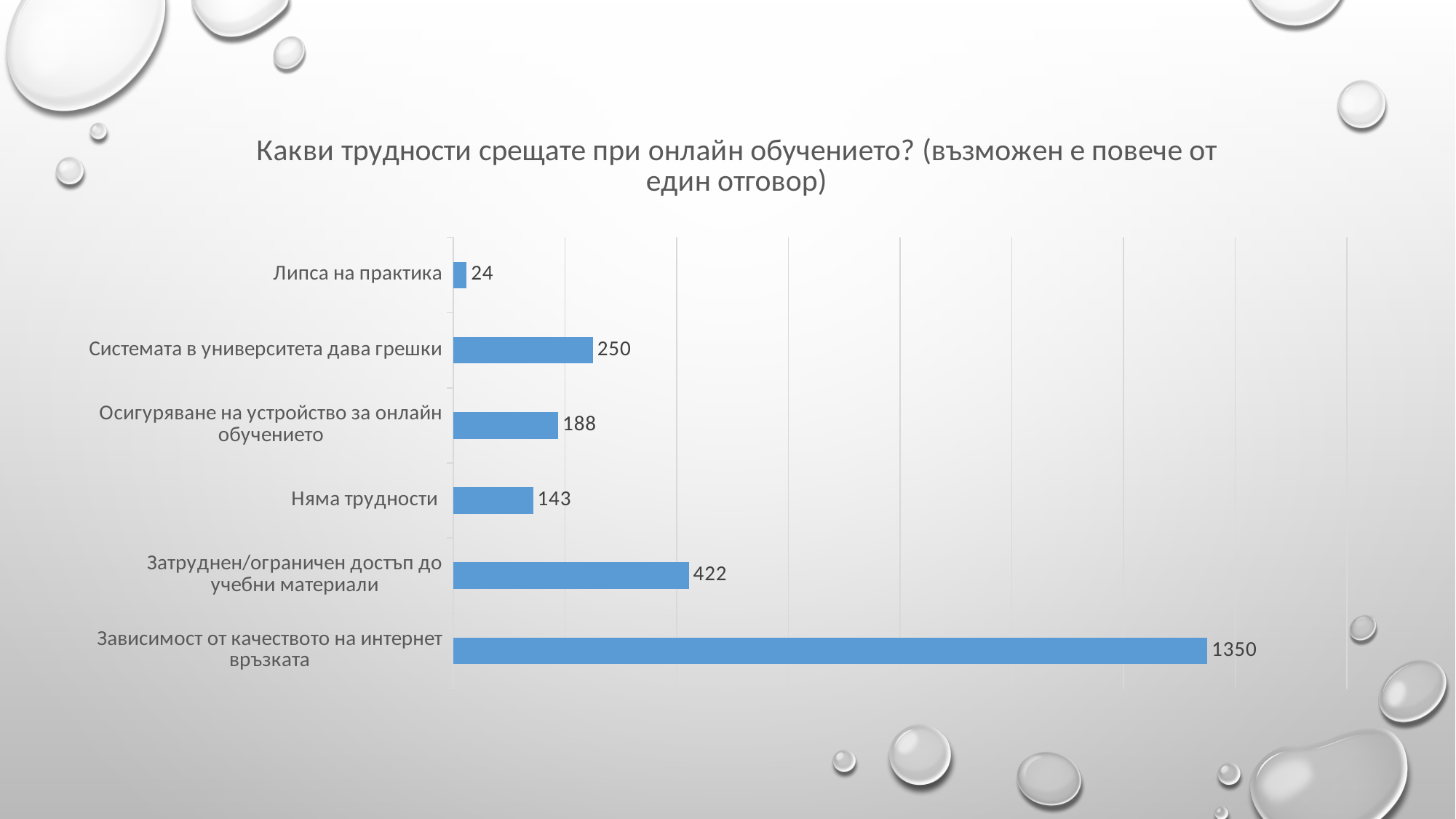
Which is larger: the value for "Осигуряване на устройство за онлайн обучението" or the value for "Няма трудности"? Осигуряване на устройство за онлайн обучението What is the difference between the values for "Затруднен/ограничен достъп до учебни материали" and "Системата в университета дава грешки"? 172 What is the value for "Липса на практика"? 24 What is the value for "Системата в университета дава грешки"? 250 What is the value for "Няма трудности"? 143 How many categories are shown in the chart? 6 What kind of chart is shown on the slide? Bar chart Which category has the lowest value? Липса на практика What is the title of the chart? Какви трудности срещате при онлайн обучението? (възможен е повече от един отговор) What is the difference between the values for "Зависимост от качеството на интернет връзката" and "Затруднен/ограничен достъп до учебни материали"? 928 What is the value for "Зависимост от качеството на интернет връзката"? 1350 Which category has the highest value? Зависимост от качеството на интернет връзката